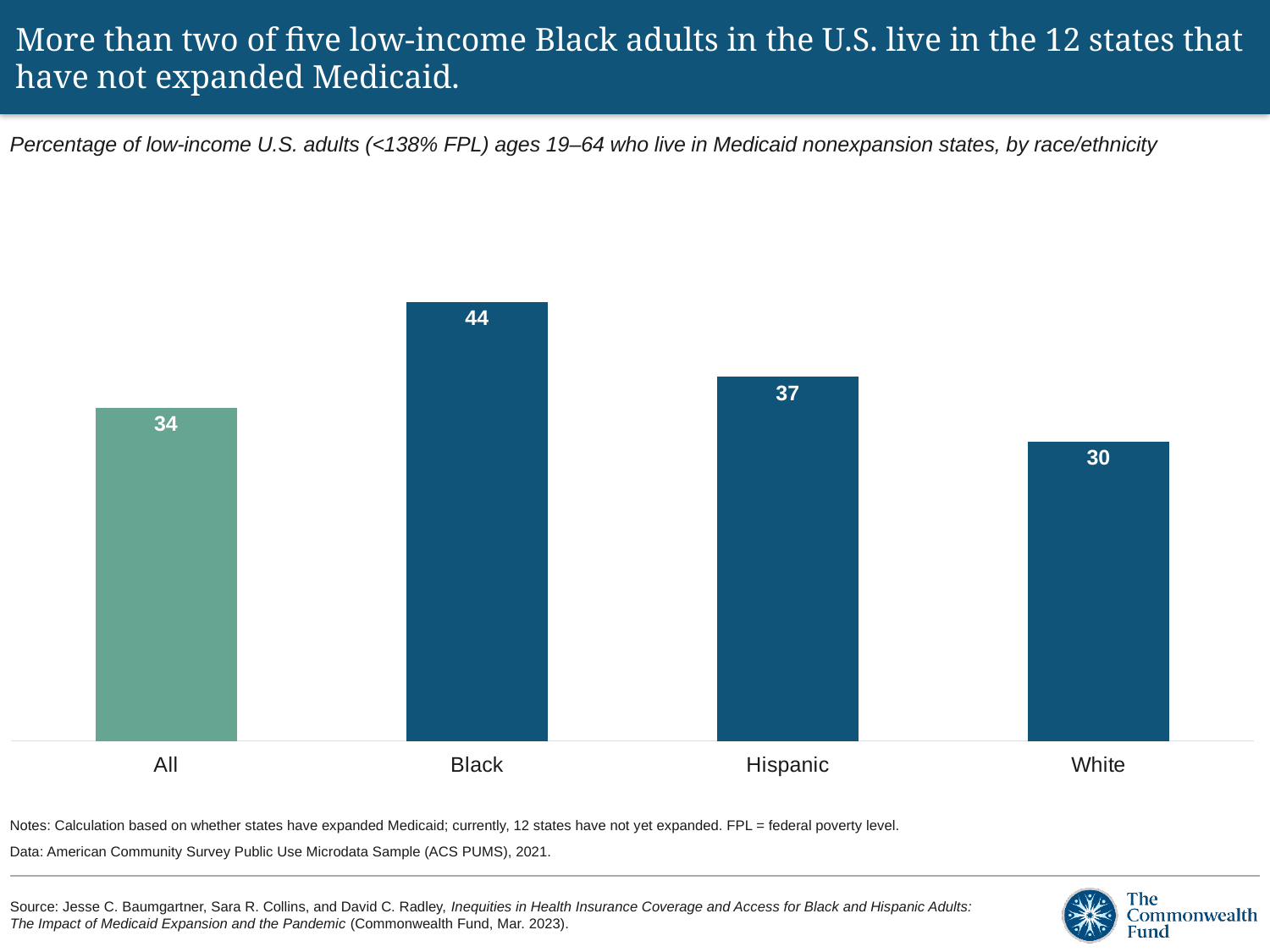
What is the difference between the values for Hispanic adults and the All category? 3 Which is larger, the value for Hispanic adults or the value for White adults? Hispanic What is the difference between the values for Black and White adults? 14 What kind of chart is shown on the slide? Bar chart What is the value for Black adults? 44 What is the value for the All category? 34 What is the value for Hispanic adults? 37 What is the value for White adults? 30 How many categories are shown on the chart? 4 Which bar is shown in a different colour from the others? All Which category has the highest value? Black Which category has the lowest value? White